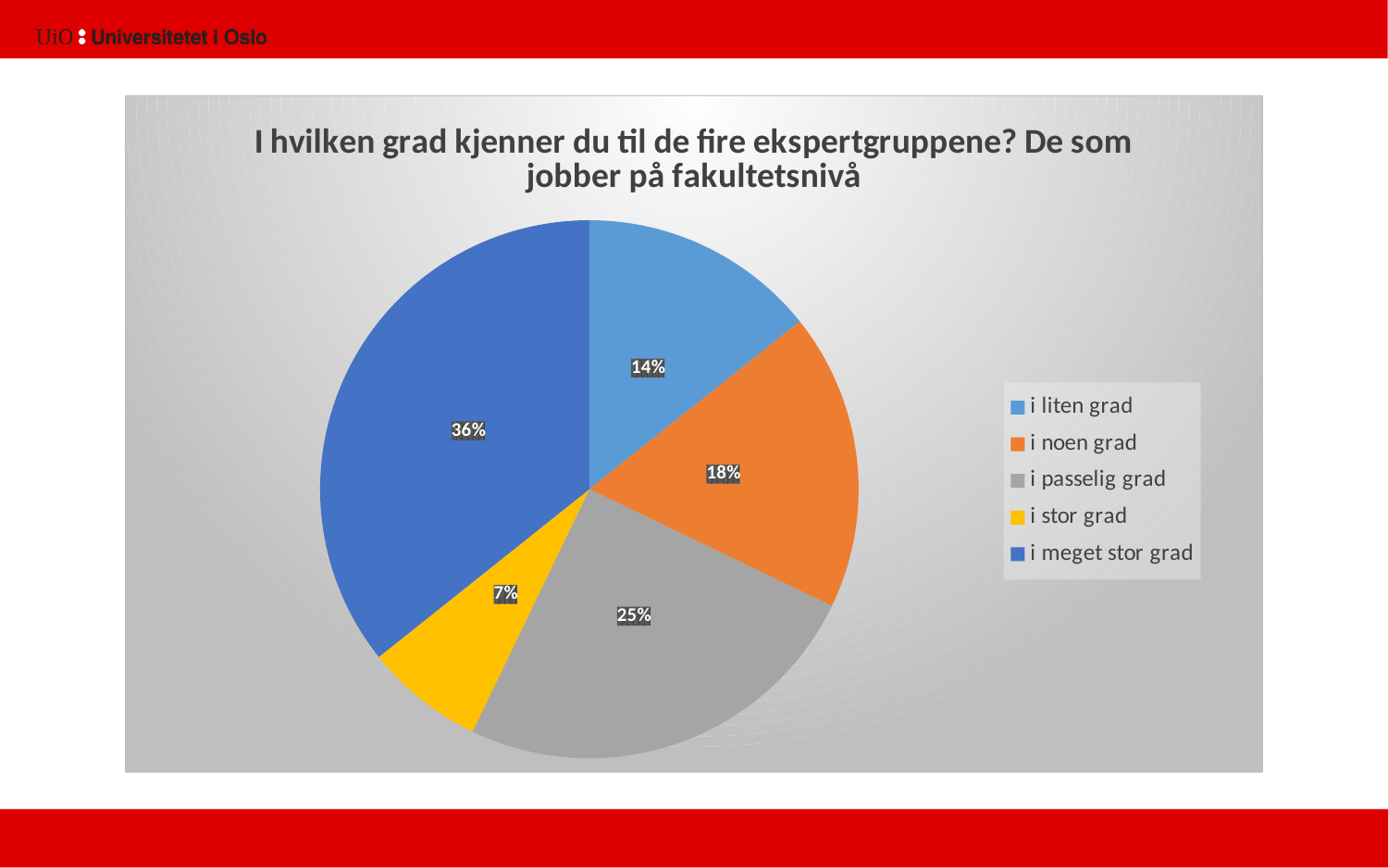
What percentage of respondents answered "i passelig grad"? 25% What percentage of respondents answered "i stor grad"? 7% What percentage of respondents answered "i liten grad"? 14% What is the difference in percentage points between "i meget stor grad" and "i passelig grad"? 11 What percentage of respondents answered "i meget stor grad"? 36% What is the combined share of "i stor grad" and "i meget stor grad"? 43% Which category has the largest share of the pie? i meget stor grad How many categories does the pie chart have? 5 What kind of chart is shown on the slide? pie chart What colour is the slice for "i stor grad"? yellow Which is larger, the share for "i noen grad" or the share for "i liten grad"? i noen grad Which category has the smallest share of the pie? i stor grad